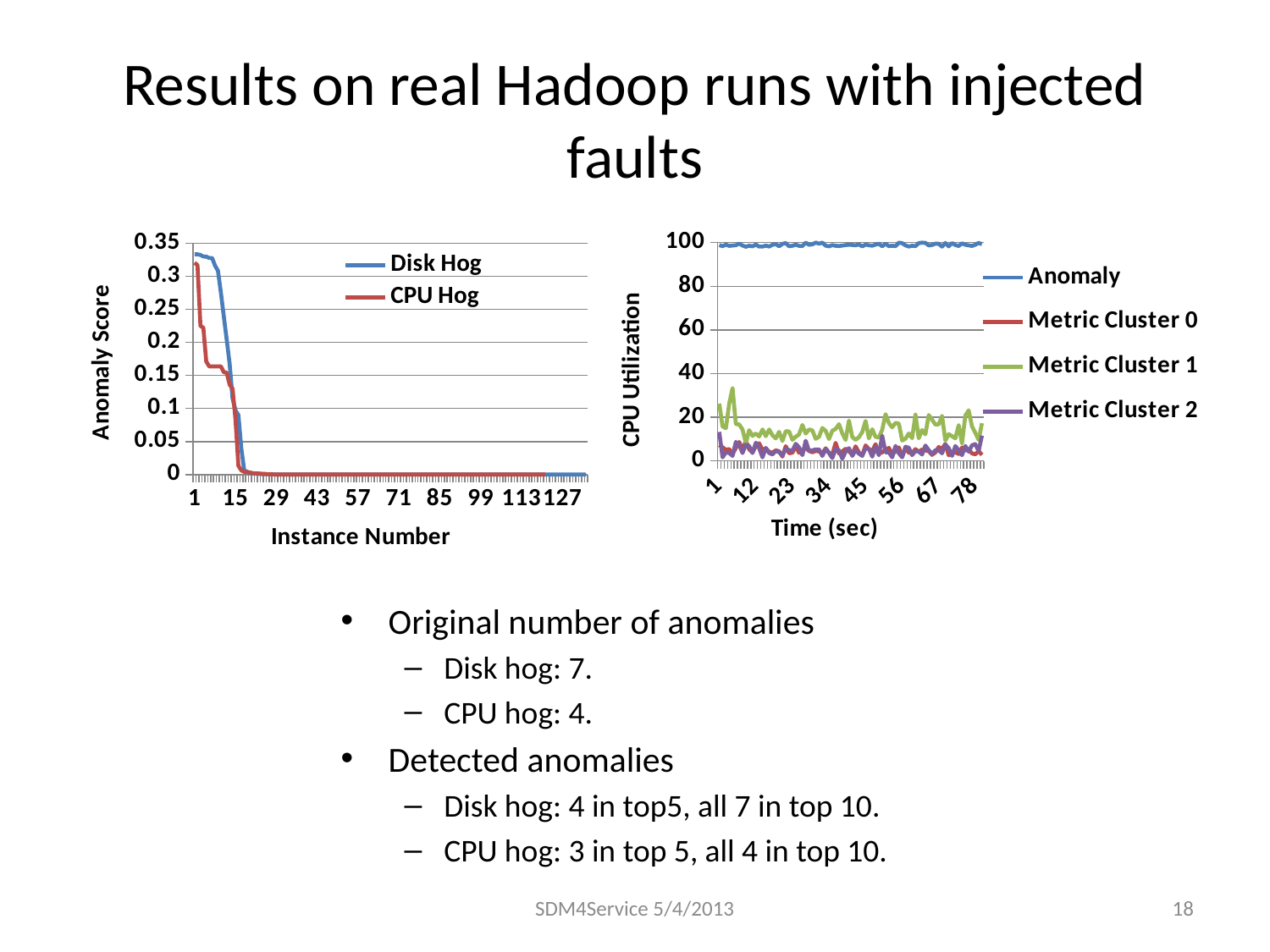
How many series does the legend of the right chart (CPU Utilization) list? 4 What kind of chart is the left chart (Anomaly Score vs Instance Number)? line chart In the right chart, is the CPU Utilization of the Anomaly series at time 45 greater or less than 80? greater In the right chart, is the CPU Utilization of Metric Cluster 1 at time 45 greater or less than 40? less How many series does the legend of the left chart (Anomaly Score) list? 2 What is the x-axis title of the right chart? Time (sec) In the right chart, which series has the highest CPU Utilization across the time range? Anomaly What kind of chart is the right chart (CPU Utilization vs Time)? line chart In the left chart, do the Disk Hog anomaly scores rise or fall as the instance number increases? fall In the right chart, which series is higher at time 12: Anomaly or Metric Cluster 2? Anomaly In the left chart, is the Disk Hog anomaly score at instance 1 greater or less than 0.3? greater